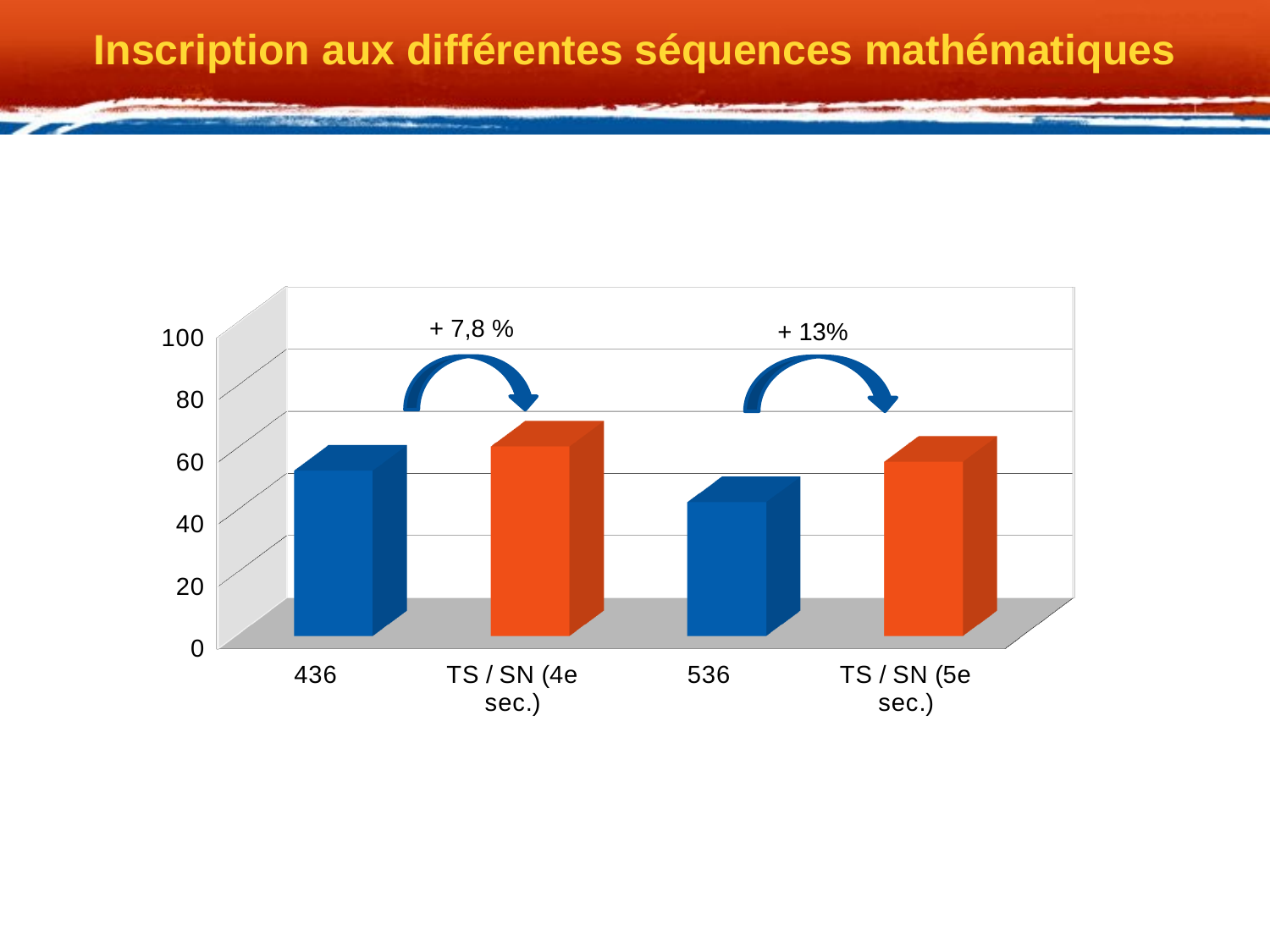
Is the value for TS / SN (5e sec.) greater or less than 80? less Is the value for 536 greater or less than 60? less Which category has the highest bar? TS / SN (4e sec.) Which is larger, the value for 436 or the value for 536? 436 What percentage change is annotated above the arrow between 536 and TS / SN (5e sec.)? + 13% Is the value for 436 greater or less than 40? greater Which category has the lowest bar? 536 What is the title of the slide containing the chart? Inscription aux différentes séquences mathématiques What kind of chart is shown on the slide? bar chart How many bars are plotted in the chart? 4 Which is larger, the value for TS / SN (4e sec.) or the value for TS / SN (5e sec.)? TS / SN (4e sec.)